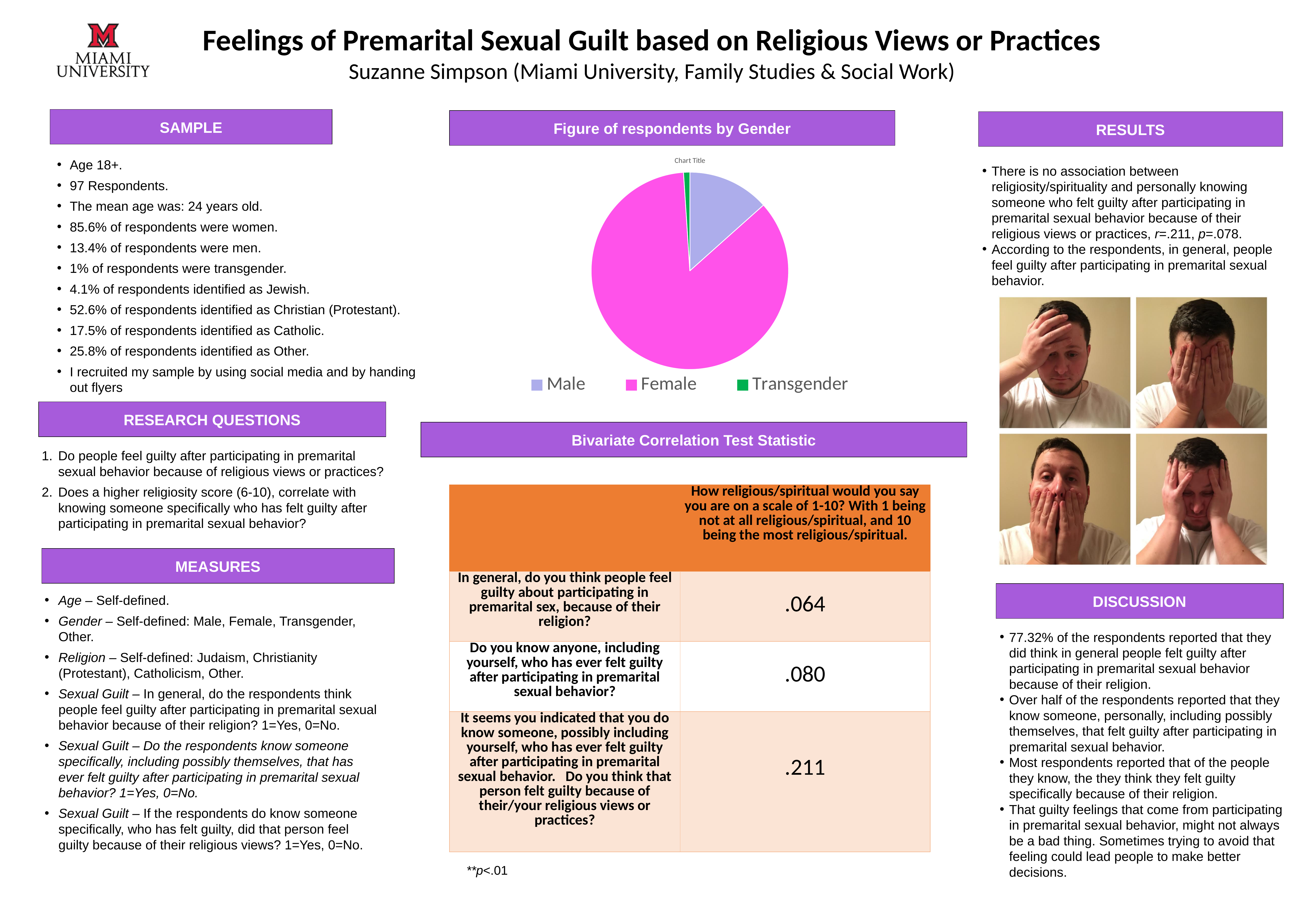
In the pie chart of respondents by gender, which category has the smallest slice? Transgender What colour is the Female slice in the pie chart of respondents by gender? pink In the pie chart of respondents by gender, which slice is larger, Female or Male? Female In the pie chart of respondents by gender, which category has the largest slice? Female In the pie chart of respondents by gender, does the Female slice take up more or less than half of the pie? more In the pie chart of respondents by gender, which slice is larger, Male or Transgender? Male What kind of chart is shown under the heading 'Figure of respondents by Gender'? pie chart What title is printed above the pie chart of respondents by gender? Chart Title How many categories does the legend of the pie chart of respondents by gender list? 3